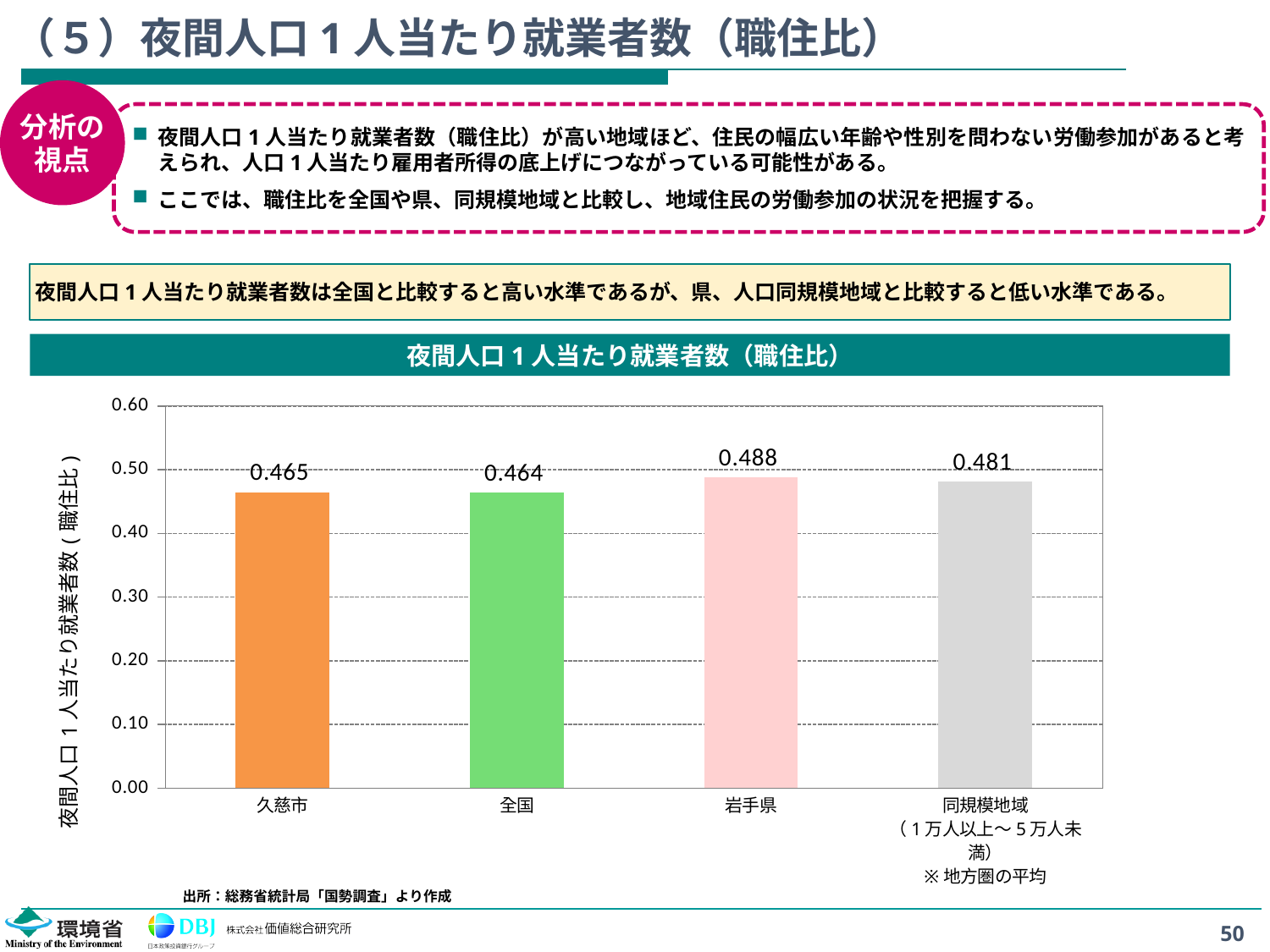
What is the difference between the values for 岩手県 and 久慈市? 0.023 What is the value for 全国 in the chart? 0.464 Is the value for 久慈市 greater or less than 0.50? less Which is larger, the value for 岩手県 or the value for 久慈市? 岩手県 Which category has the highest value in the chart? 岩手県 What is the value for 久慈市 in the chart? 0.465 What kind of chart is shown on the slide? bar chart Which category has the lowest value in the chart? 全国 How many categories are shown in the chart? 4 What is the value for 同規模地域（１万人以上～５万人未満） in the chart? 0.481 What is the value for 岩手県 in the chart? 0.488 What is the difference between the values for 同規模地域 and 全国? 0.017